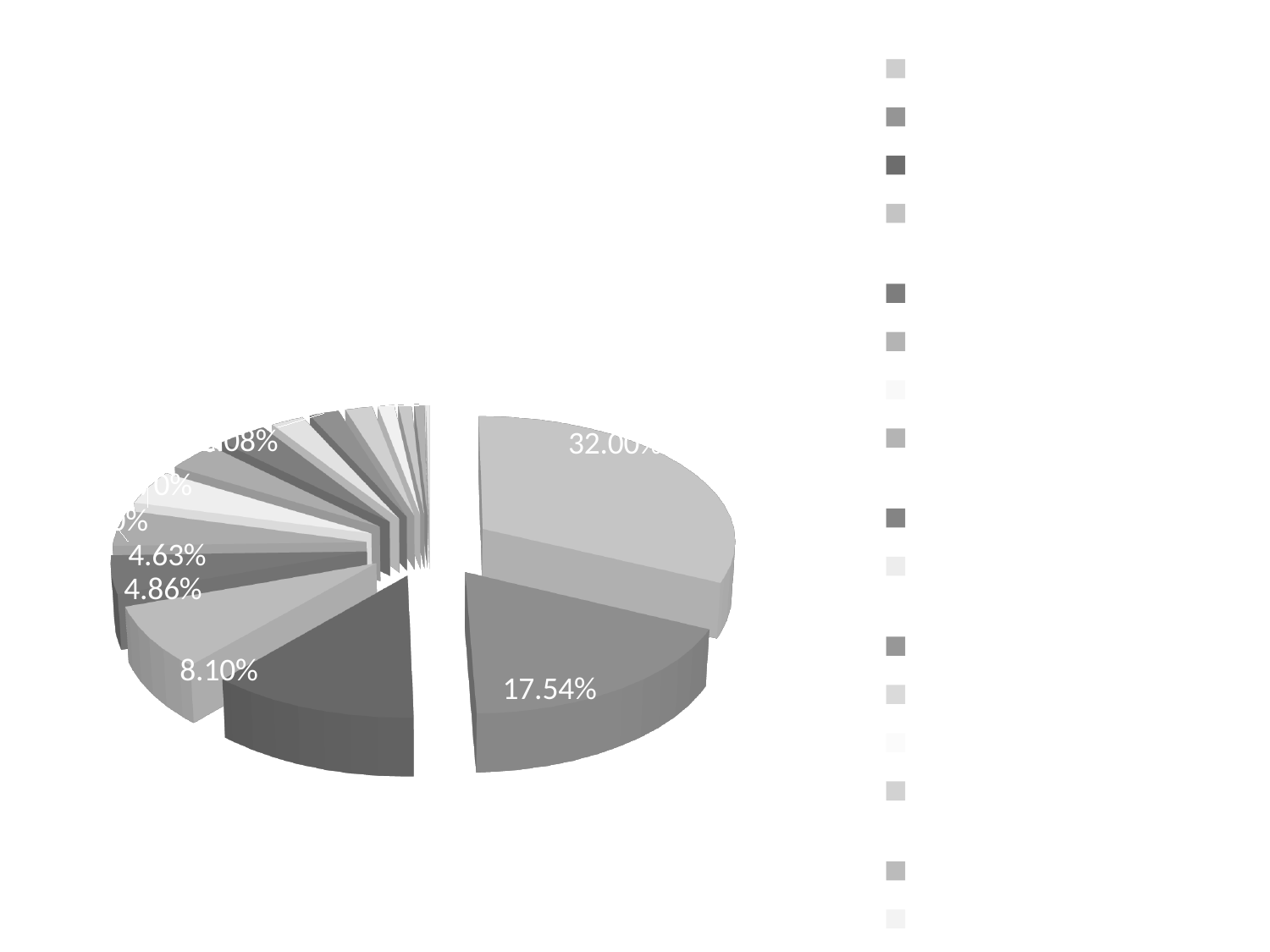
What kind of chart is shown on the slide? pie chart Are the slices of the pie chart exploded (separated from each other)? yes What is the value of the largest slice in the pie chart? 32.00% Which is larger, the slice labelled 8.10% or the slice labelled 4.86%? 8.10% What share of the pie does the largest slice represent? 32.00% What is the difference between the slices labelled 4.86% and 4.63%? 0.23% What is the difference between the largest slice (32.00%) and the second-largest slice (17.54%)? 14.46% Is the pie chart drawn in 3D or flat 2D? 3D What is the value of the second-largest slice in the pie chart? 17.54%